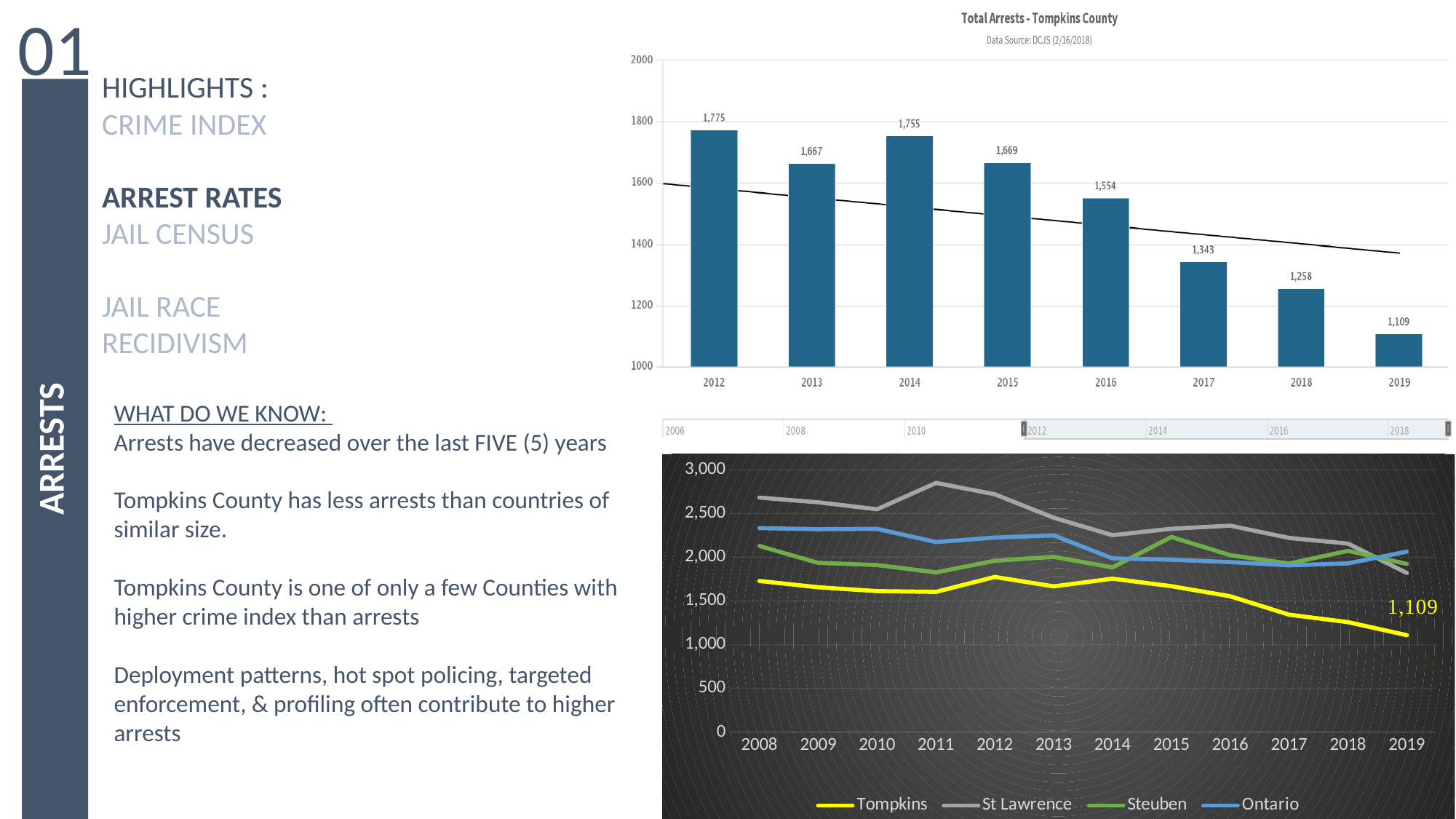
In the 'Total Arrests - Tompkins County' bar chart, which year had the highest number of arrests? 2012 How many years are shown in the 'Total Arrests - Tompkins County' bar chart? 8 In the line chart at the bottom right of the slide, is the value for Tompkins in 2008 greater or less than 2,000? less In the 'Total Arrests - Tompkins County' bar chart, which year had the lowest number of arrests? 2019 In the 'Total Arrests - Tompkins County' bar chart, what was the total number of arrests in 2012? 1,775 In the 'Total Arrests - Tompkins County' bar chart, what was the total number of arrests in 2017? 1,343 How many series does the legend of the line chart at the bottom right of the slide list? 4 In the 'Total Arrests - Tompkins County' bar chart, do arrests generally rise or fall from 2015 to 2019? Fall What kind of chart is the 'Total Arrests - Tompkins County' chart at the top right of the slide? Bar chart In the 'Total Arrests - Tompkins County' bar chart, what is the difference between the arrests in 2012 and 2019? 666 In the 'Total Arrests - Tompkins County' bar chart, which year had more arrests, 2013 or 2015? 2015 In the line chart at the bottom right of the slide, what is the labelled value for Tompkins in 2019? 1,109